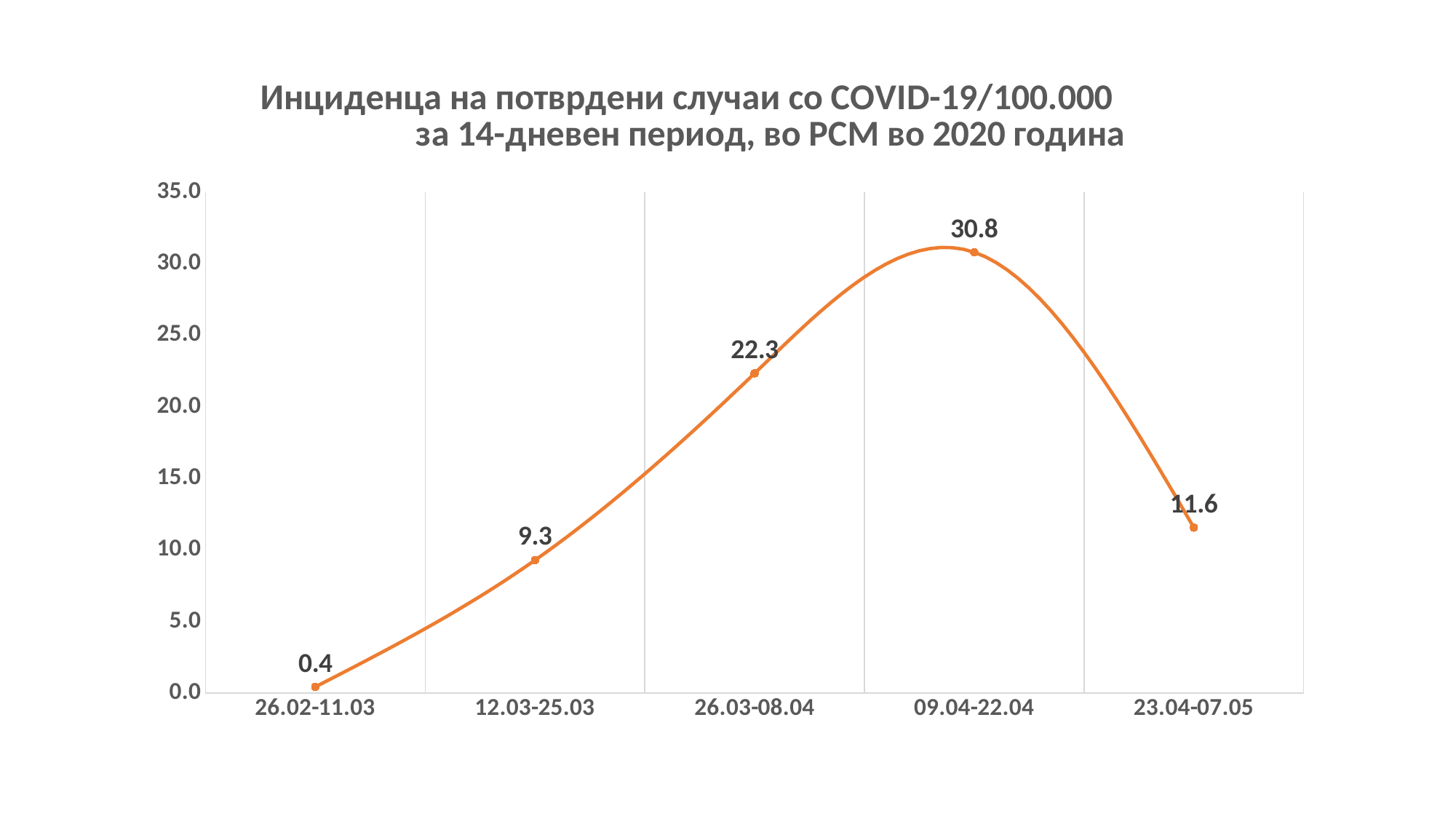
What is the value for the period 26.02-11.03? 0.4 What is the value for the period 23.04-07.05? 11.6 Which period has the highest value? 09.04-22.04 How many periods are plotted on the chart? 5 Is the value for 09.04-22.04 greater or less than 30.0? greater Which is larger, the value for 12.03-25.03 or the value for 23.04-07.05? 23.04-07.05 What is the value for the period 12.03-25.03? 9.3 What kind of chart is shown on the slide? line chart Do the values rise or fall between 09.04-22.04 and 23.04-07.05? fall What is the value for the period 26.03-08.04? 22.3 What is the difference between the values for 09.04-22.04 and 26.03-08.04? 8.5 Which period has the lowest value? 26.02-11.03